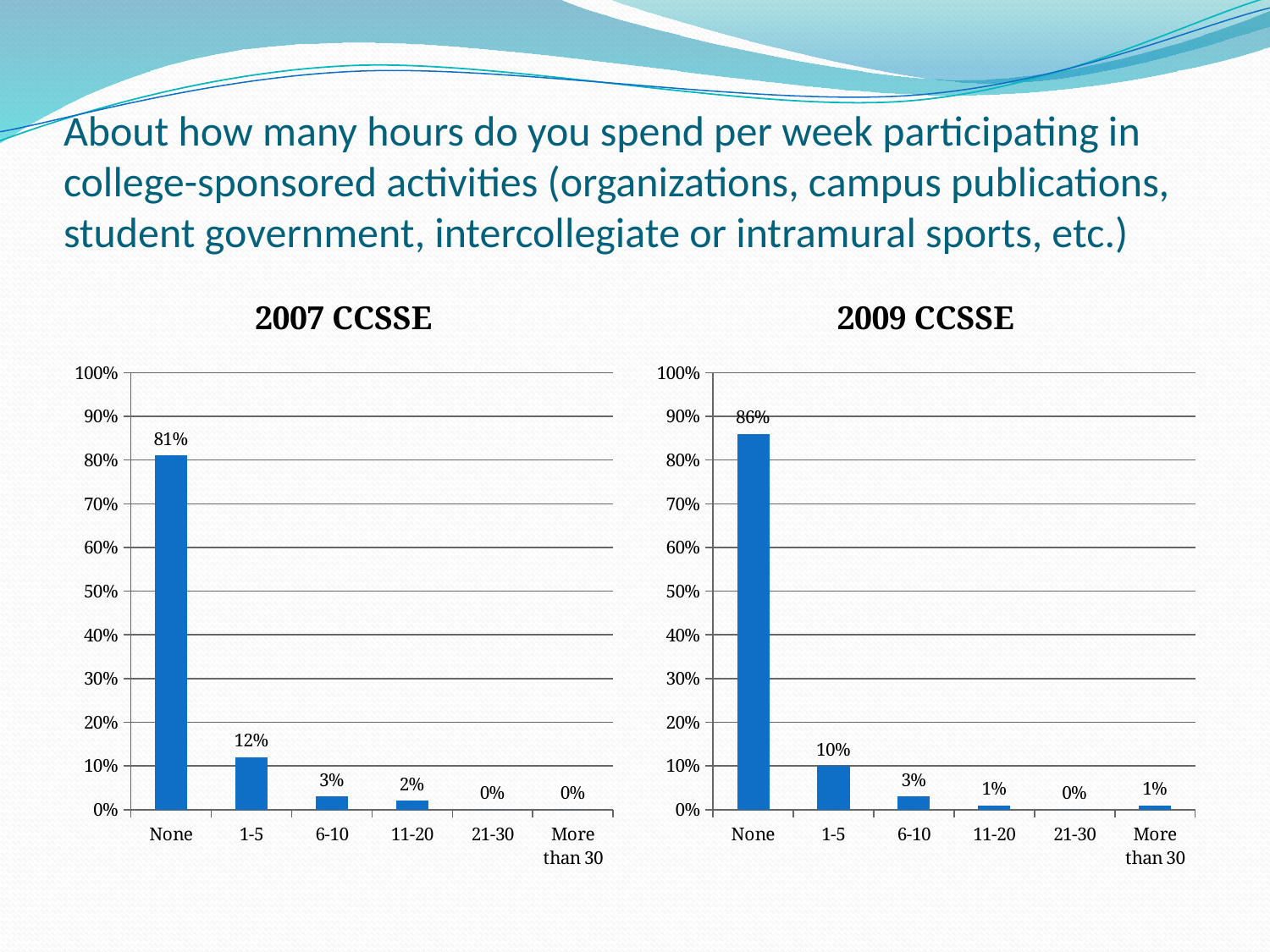
In the 2009 CCSSE chart, which category has the highest value? None What kind of chart is the 2009 CCSSE chart? bar chart In the 2007 CCSSE chart, do the values generally rise or fall from None to 21-30? fall In the 2009 CCSSE chart, is the value for 1-5 greater or less than 20%? less In the 2007 CCSSE chart, what is the value for 1-5 hours? 12% In the 2009 CCSSE chart, what is the value for None? 86% What is the title of the chart on the left? 2007 CCSSE In the 2007 CCSSE chart, what is the value for None? 81% How many categories are shown on the x axis of the 2007 CCSSE chart? 6 In the 2009 CCSSE chart, what is the value for More than 30 hours? 1% Which is larger: the value for None in the 2007 CCSSE chart or in the 2009 CCSSE chart? 2009 CCSSE In the 2007 CCSSE chart, what is the difference between the values for None and 1-5? 69%